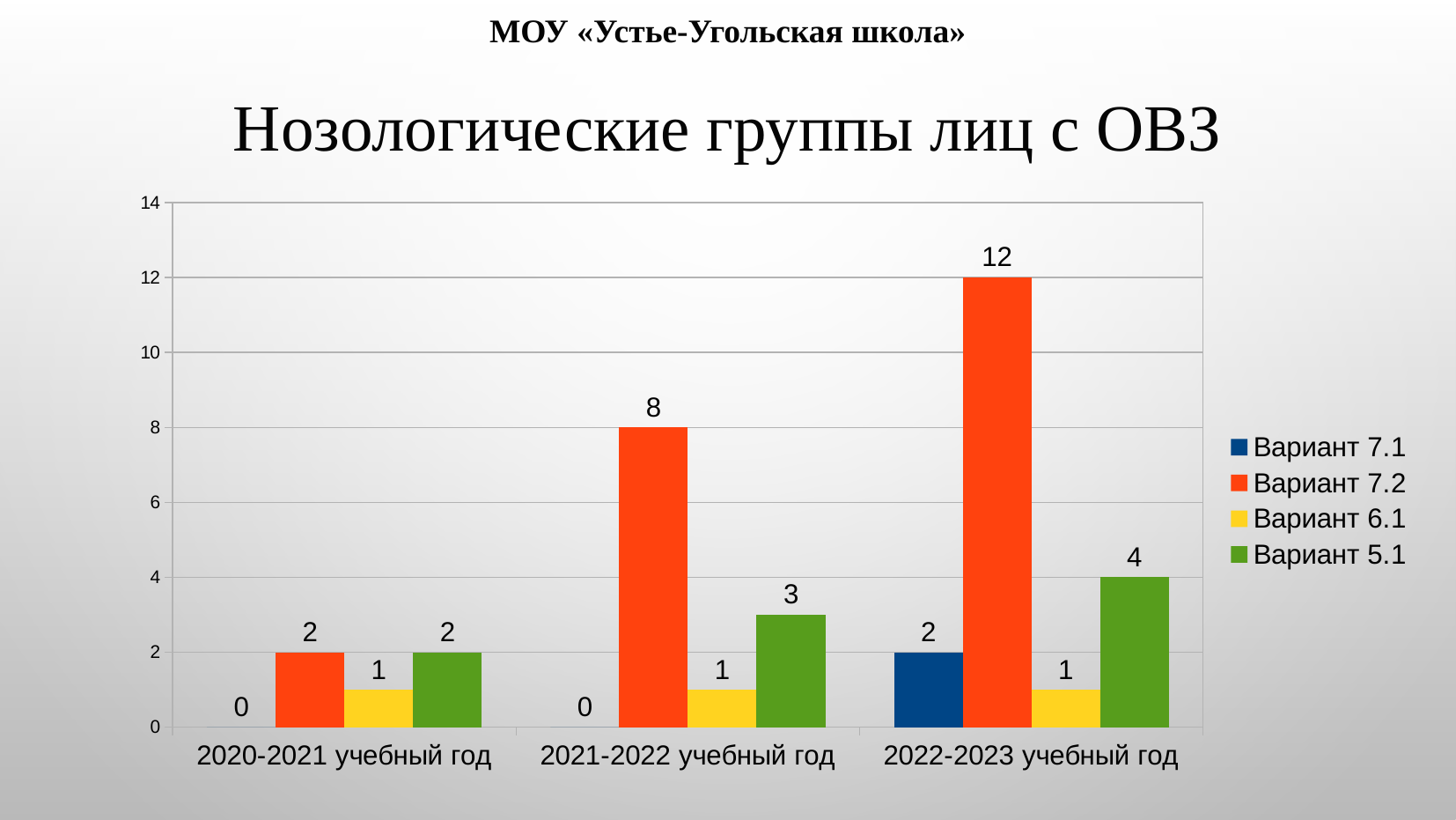
What is the value for Вариант 7.1 in 2020-2021 учебный год? 0 How many school years are shown on the x axis? 3 Does the value for Вариант 7.2 rise or fall across the school years from 2020-2021 to 2022-2023? rise What is the value for Вариант 5.1 in 2021-2022 учебный год? 3 Which school year has the highest value for Вариант 7.2? 2022-2023 учебный год What kind of chart is shown on the slide? bar chart What is the value for Вариант 7.2 in 2022-2023 учебный год? 12 How many series does the legend list? 4 What is the difference between the Вариант 7.2 values for 2022-2023 учебный год and 2021-2022 учебный год? 4 What is the value for Вариант 6.1 in 2022-2023 учебный год? 1 Which school year has the lowest value for Вариант 5.1? 2020-2021 учебный год Which is larger: Вариант 5.1 in 2022-2023 учебный год or Вариант 7.1 in 2022-2023 учебный год? Вариант 5.1 in 2022-2023 учебный год